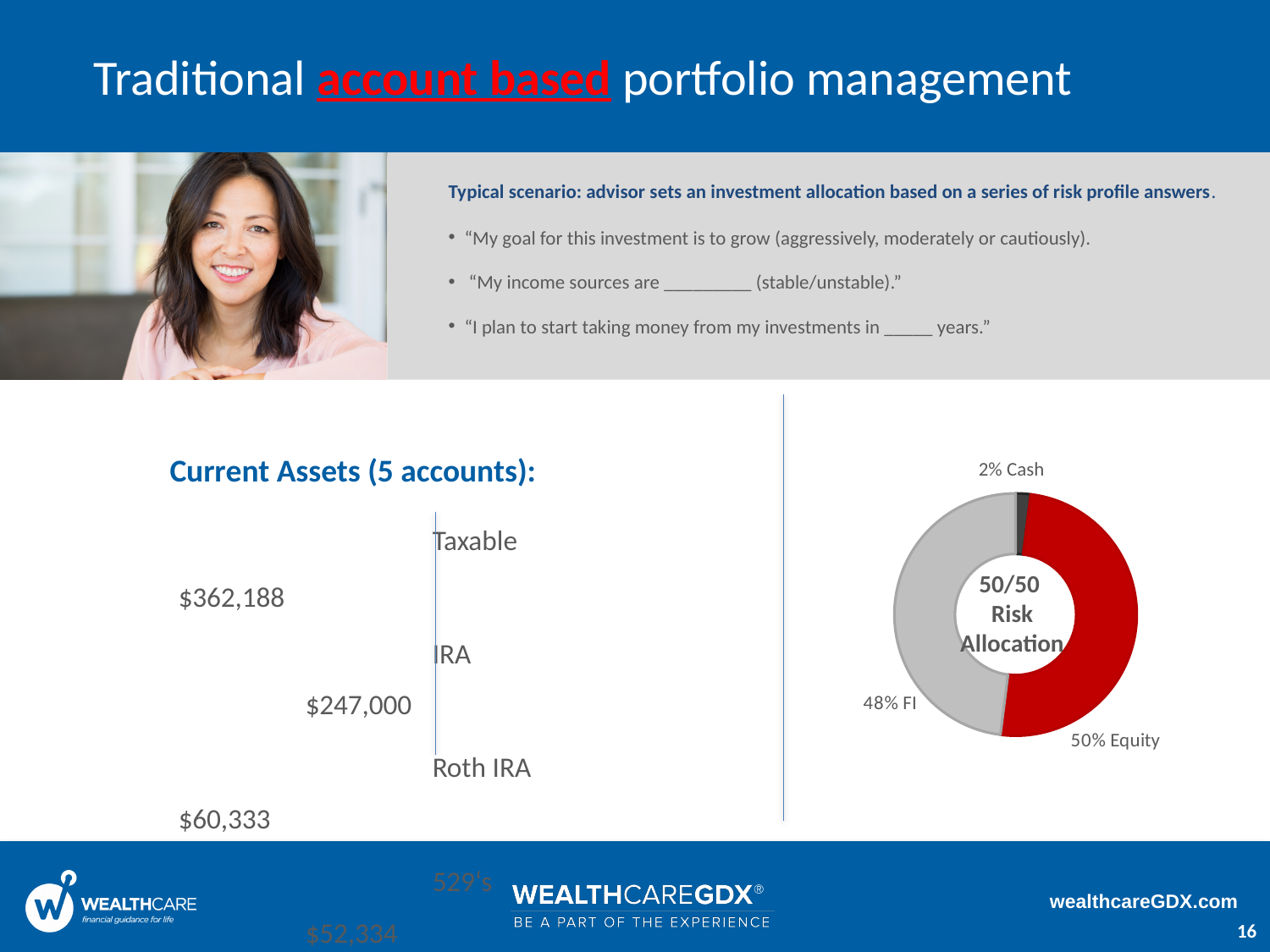
In the donut chart on the right, what is the difference in percentage points between the Equity share and the FI share? 2 In the donut chart on the right, what share is labelled for Equity? 50% In the donut chart on the right, which category has the smallest share? Cash In the donut chart on the right, how many categories are shown? 3 In the donut chart on the right, what share is labelled for Cash? 2% In the donut chart on the right, what share is labelled for FI? 48% In the Current Assets chart on the left, what is the value shown for IRA? $247,000 What kind of chart is shown on the right side of the slide? Donut (pie) chart In the Current Assets chart on the left, what is the value shown for Taxable? $362,188 In the Current Assets chart on the left, which is larger, the Taxable value or the Roth IRA value? Taxable In the donut chart on the right, which category has the largest share? Equity What text is written in the centre of the donut chart on the right? 50/50 Risk Allocation